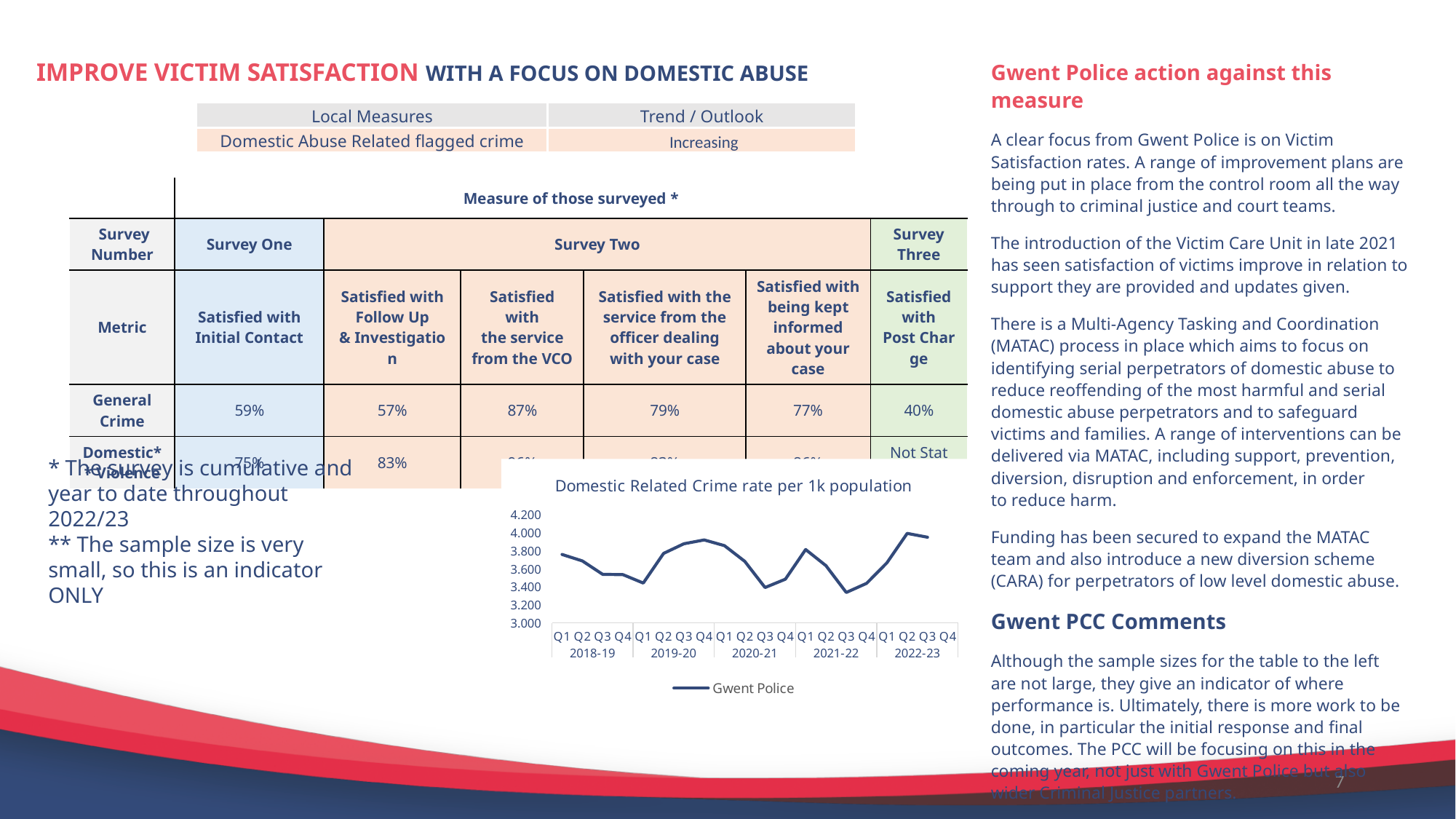
In the 'Domestic Related Crime rate per 1k population' chart, which is larger: the value for Q3 2021-22 or the value for Q2 2022-23? Q2 2022-23 In the 'Domestic Related Crime rate per 1k population' chart, is the value for Q4 2019-20 greater or less than 3.800? greater How many series does the legend of the 'Domestic Related Crime rate per 1k population' chart list? 1 What kind of chart is the 'Domestic Related Crime rate per 1k population' chart? line chart In the 'Domestic Related Crime rate per 1k population' chart, is the value for Q1 2018-19 greater or less than 3.600? greater What is the highest value shown on the y axis of the 'Domestic Related Crime rate per 1k population' chart? 4.200 What is the name of the series shown in the legend of the 'Domestic Related Crime rate per 1k population' chart? Gwent Police In the 'Domestic Related Crime rate per 1k population' chart, is the value for Q3 2021-22 greater or less than 3.600? less In the 'Domestic Related Crime rate per 1k population' chart, does the value rise or fall from Q1 2018-19 to Q1 2019-20? fall In the 'Domestic Related Crime rate per 1k population' chart, which is larger: the value for Q1 2019-20 or the value for Q4 2019-20? Q4 2019-20 How many financial years are shown on the x axis of the 'Domestic Related Crime rate per 1k population' chart? 5